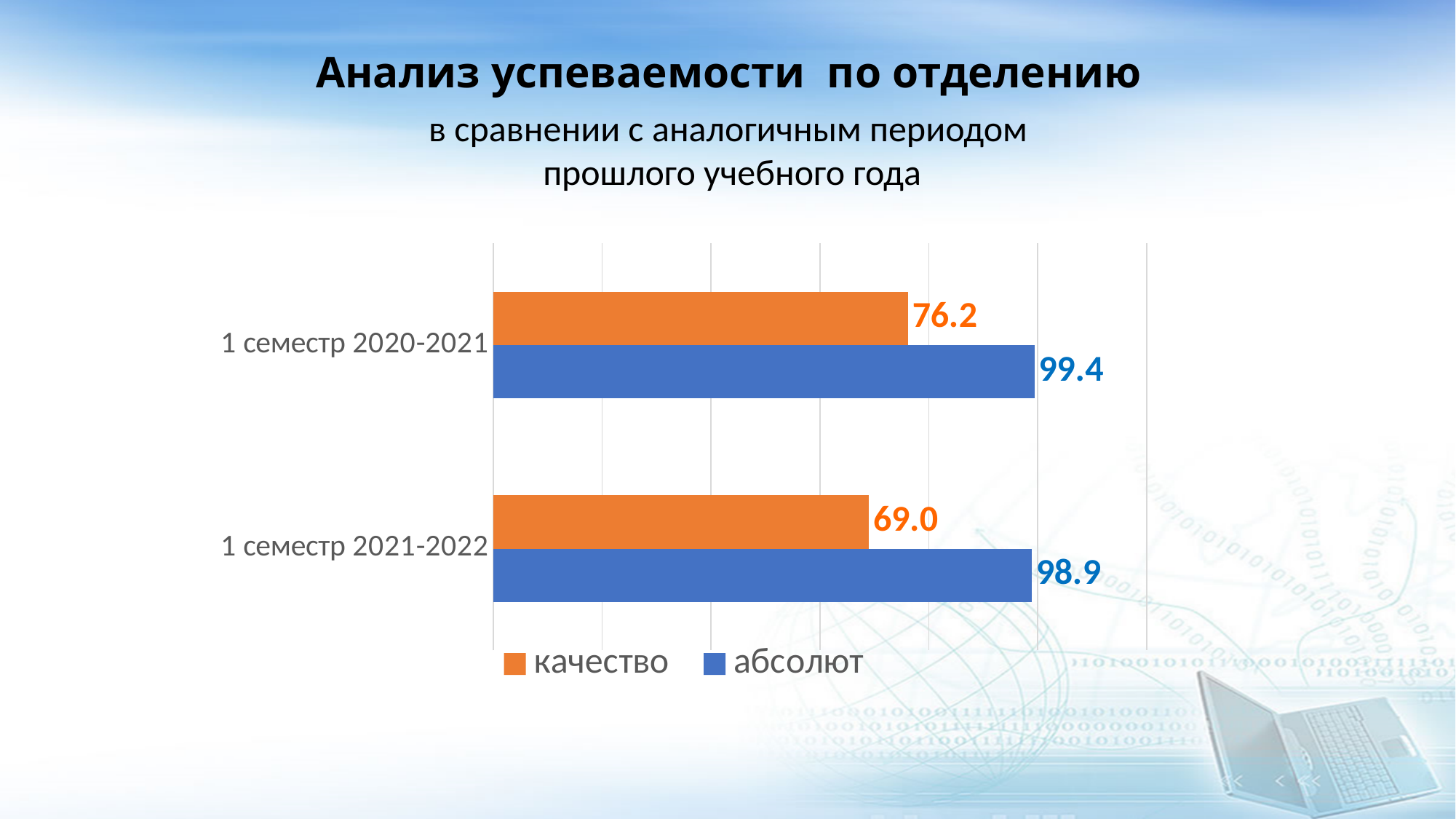
What kind of chart is shown on the slide? bar chart How many categories are shown on the chart? 2 What is the difference between the абсолют values for 1 семестр 2020-2021 and 1 семестр 2021-2022? 0.5 Which is larger for 1 семестр 2021-2022: качество or абсолют? абсолют What is the difference between the качество values for 1 семестр 2020-2021 and 1 семестр 2021-2022? 7.2 What is the value of абсолют for 1 семестр 2020-2021? 99.4 What is the value of качество for 1 семестр 2021-2022? 69.0 Which category has the higher качество value? 1 семестр 2020-2021 What is the value of качество for 1 семестр 2020-2021? 76.2 What is the value of абсолют for 1 семестр 2021-2022? 98.9 Which category has the lower качество value? 1 семестр 2021-2022 How many series does the legend list? 2